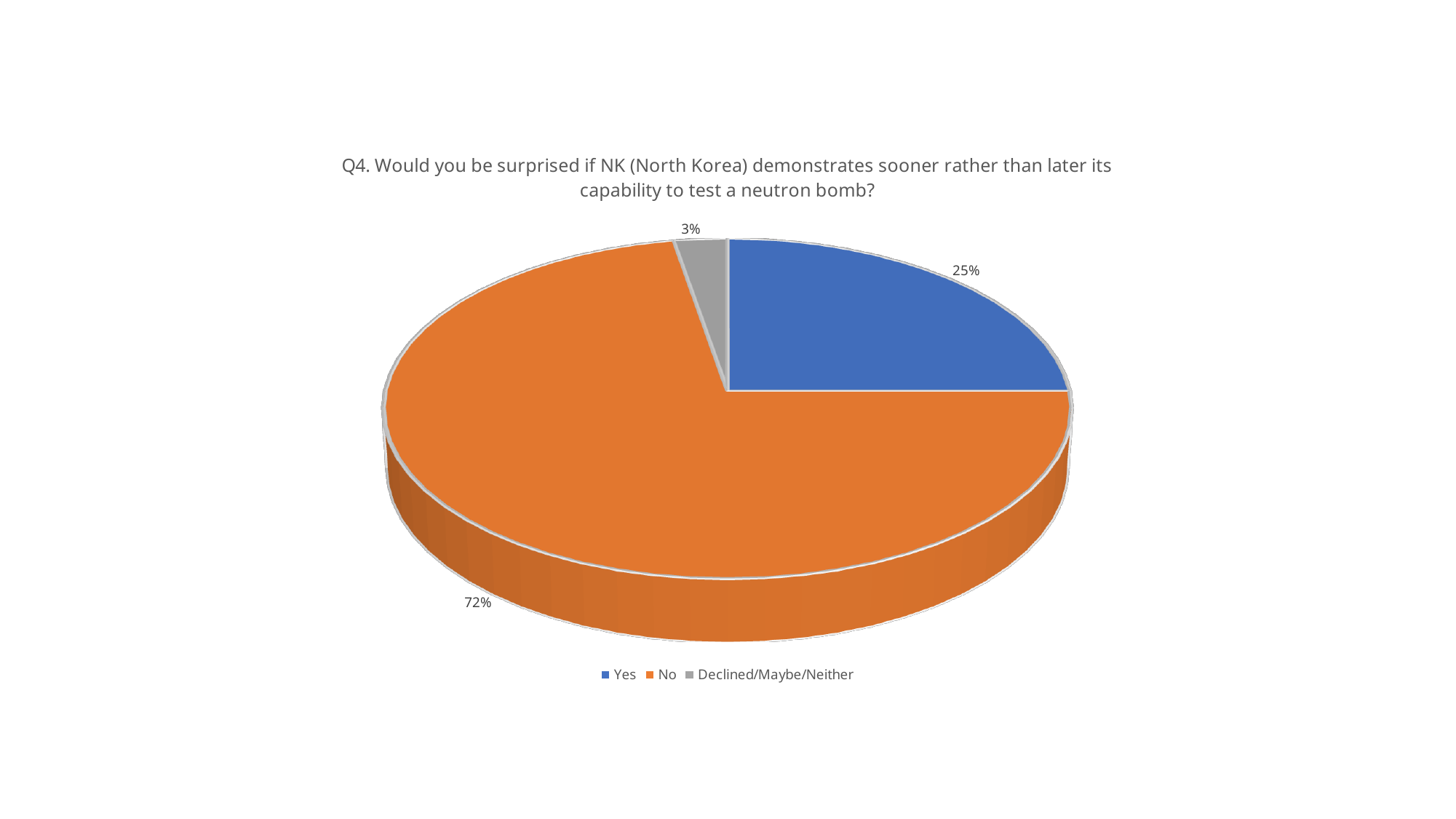
What percentage of respondents fall under "Declined/Maybe/Neither"? 3% Which response has the largest share of the pie? No How many entries does the legend list? 3 Which response has the smallest share of the pie? Declined/Maybe/Neither What percentage of respondents answered "Yes"? 25% What kind of chart is shown on the slide? Pie chart How many slices does the pie chart have? 3 What colour is the "No" slice? Orange What percentage of respondents answered "No"? 72% What is the difference in percentage points between the "No" and "Yes" shares? 47 Which is larger, the share for "Yes" or the share for "Declined/Maybe/Neither"? Yes What is the combined share of "Yes" and "Declined/Maybe/Neither"? 28%